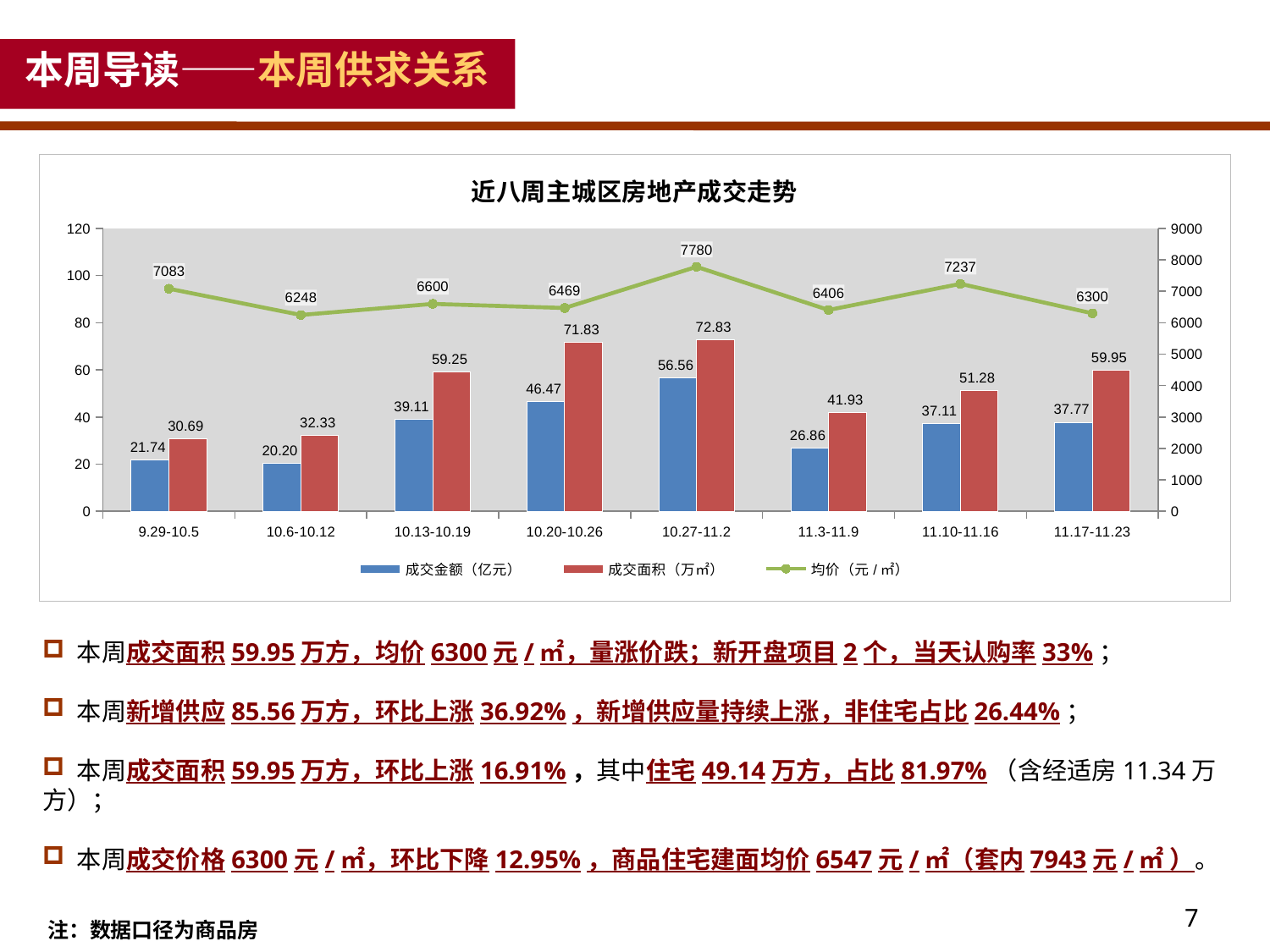
Which week has the lowest 成交金额（亿元）? 10.6-10.12 How many weeks are shown on the x axis? 8 How many series does the legend list? 3 What is the difference between the 成交面积（万㎡） values for 10.27-11.2 and 11.3-11.9? 30.90 Does the 成交金额（亿元） rise or fall from 10.6-10.12 to 10.27-11.2? Rise What is the 成交面积（万㎡） value for 11.17-11.23? 59.95 What is the 成交金额（亿元） value for 10.27-11.2? 56.56 What is the 均价（元/㎡） value for 9.29-10.5? 7083 Which is larger, the 均价（元/㎡） for 11.10-11.16 or for 10.13-10.19? 11.10-11.16 Which week has the highest 均价（元/㎡）? 10.27-11.2 What is the title of the chart? 近八周主城区房地产成交走势 What kind of chart is this? Combined bar and line chart